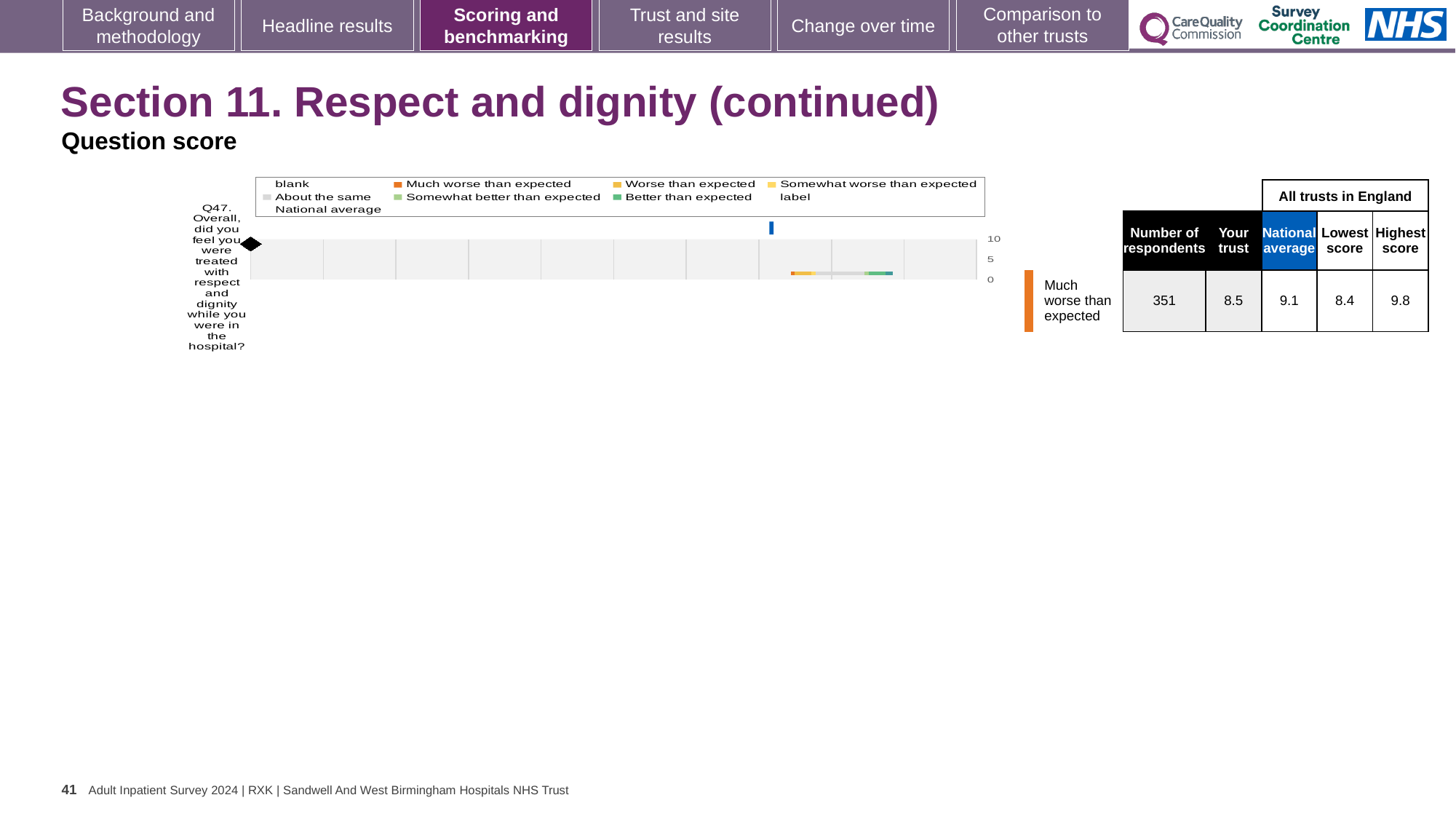
Which is larger for Q47, the 'Your trust' score or the national average? National average Which question number is plotted in the chart? Q47 What type of chart is shown on the slide? bar chart What is the 'Your trust' score for Q47 shown in the table beside the chart? 8.5 How many respondents are listed for Q47? 351 What is the national average score for Q47 shown in the table beside the chart? 9.1 Which benchmark category is shown next to the orange marker beside the chart for Q47? Much worse than expected How many questions are plotted in the chart? 1 What is the highest score among all trusts in England for Q47? 9.8 What is the lowest score among all trusts in England for Q47? 8.4 What is the difference between the highest score and the lowest score for Q47? 1.4 What is the difference between the national average and the 'Your trust' score for Q47? 0.6